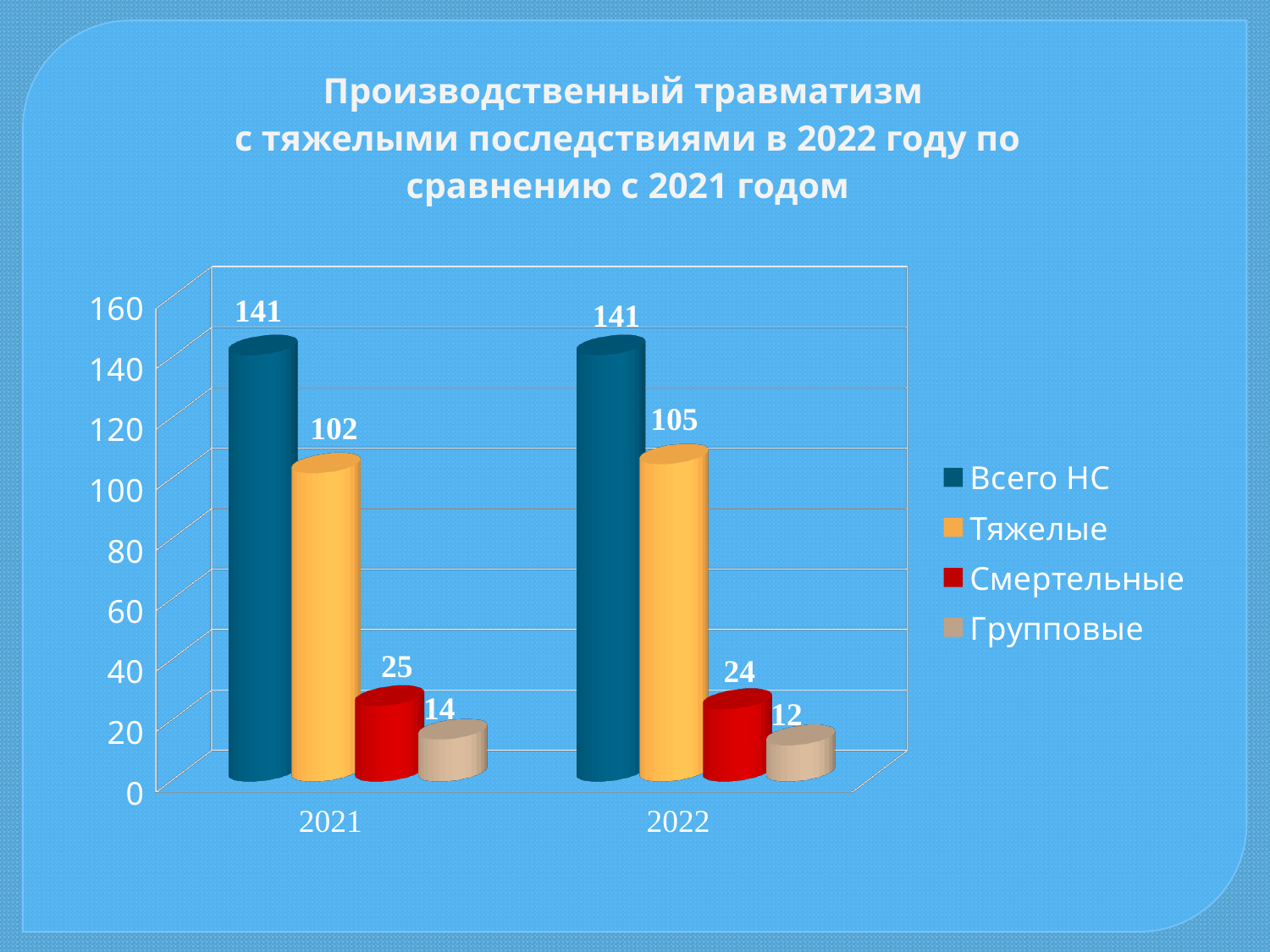
What is the value for Всего НС in 2021? 141 How many year categories are shown on the x axis? 2 What is the value for Смертельные in 2021? 25 Which is larger: Смертельные in 2021 or Смертельные in 2022? Смертельные in 2021 What kind of chart is this? Bar chart How many series does the legend list? 4 Which series has the highest value in 2021? Всего НС What is the difference between Тяжелые in 2022 and Тяжелые in 2021? 3 What is the value for Тяжелые in 2022? 105 What colour are the bars for the Смертельные series? Red Which series has the lowest value in 2022? Групповые What is the value for Групповые in 2022? 12